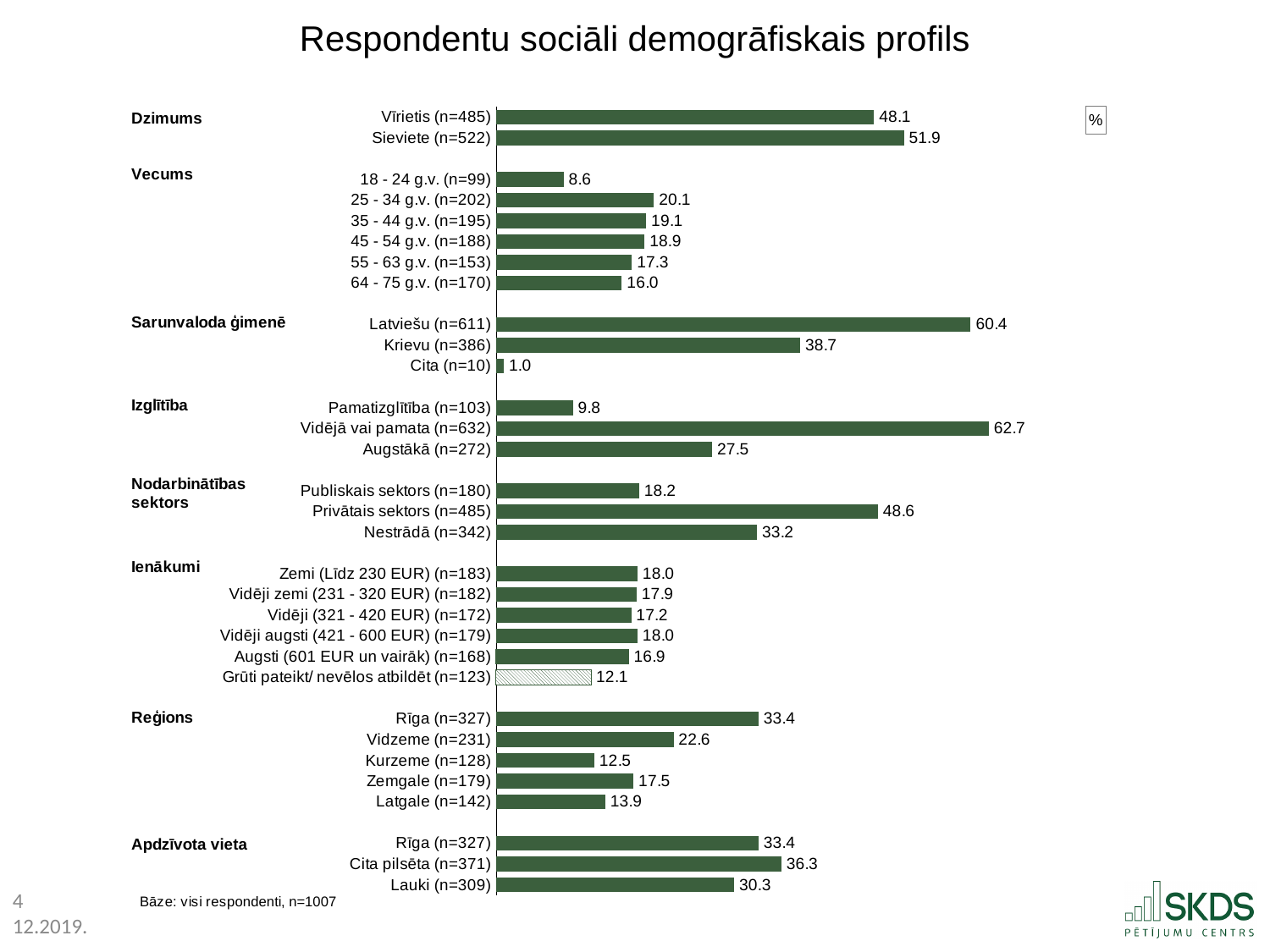
What is the value for Latviešu (n=611) under Sarunvaloda ģimenē? 60.4 What is the difference between the values for Latviešu (n=611) and Krievu (n=386)? 21.7 What is the value for Kurzeme (n=128)? 12.5 Is the value for Privātais sektors (n=485) greater or less than 40? greater What is the difference between the values for Sieviete (n=522) and Vīrietis (n=485)? 3.8 How many age groups are shown under Vecums? 6 What is the title of the chart? Respondentu sociāli demogrāfiskais profils What kind of chart is shown on the slide? bar chart Which category has the highest value on the chart? Vidējā vai pamata (n=632) Under Reģions, which is larger: Rīga (n=327) or Vidzeme (n=231)? Rīga (n=327) What is the value for Sieviete (n=522)? 51.9 Which category has the lowest value on the chart? Cita (n=10)